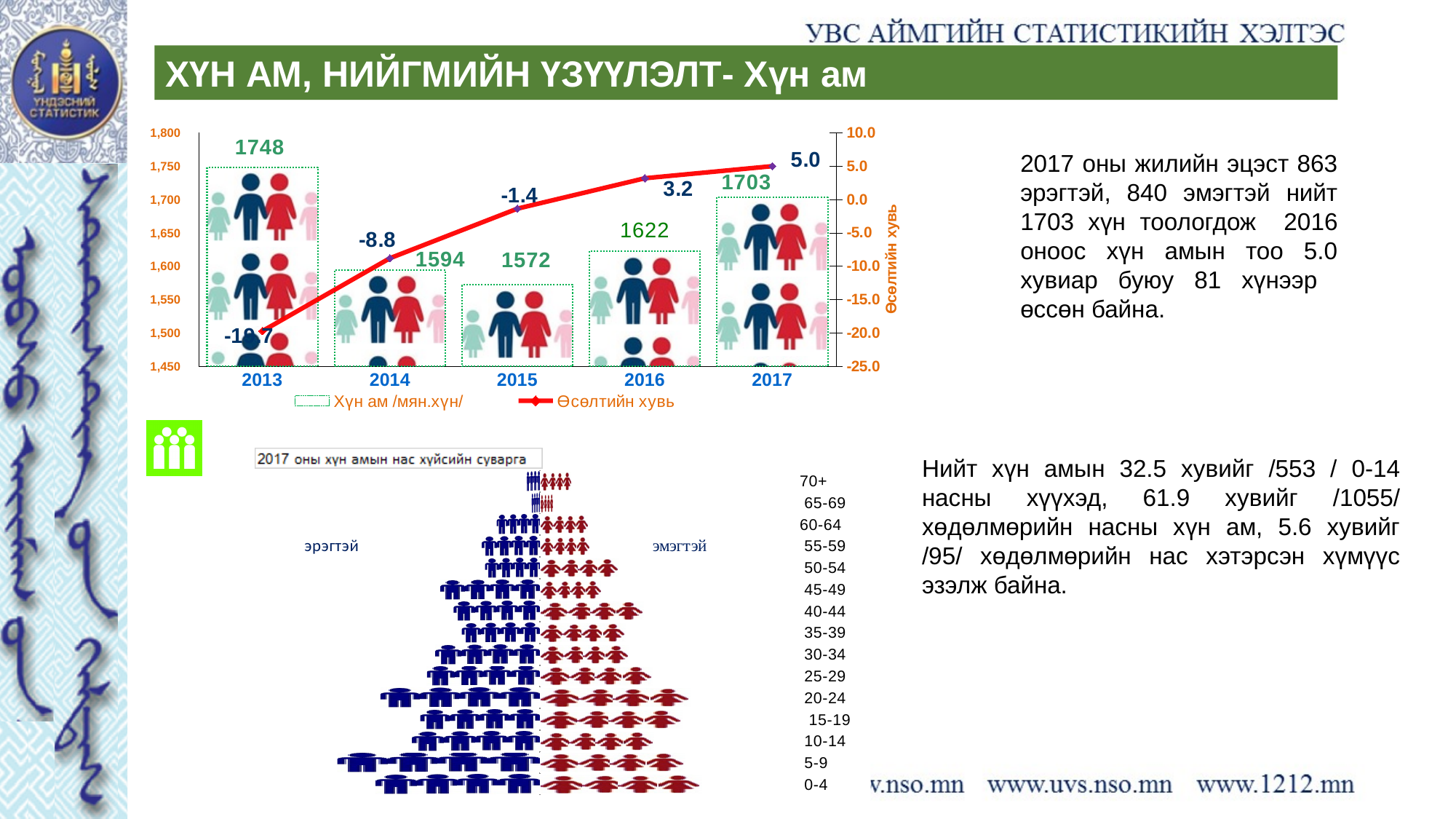
In the top chart, what is the population (Хүн ам) value shown for 2013? 1748 In the top chart, what is the difference between the population values for 2017 and 2016? 81 How many series does the legend of the top chart list? 2 How many years are shown on the x axis of the top chart? 5 In the top chart, which year has the highest population value? 2013 In the top chart, is the population value for 2016 larger or smaller than the value for 2015? larger In the top chart, what is the population value shown for 2017? 1703 In the top chart, what is the growth rate shown for 2017? 5.0 In the top chart, does the growth rate line rise or fall from 2013 to 2017? rise In the top chart, what is the growth rate (Өсөлтийн хувь) shown for 2014? -8.8 In the top chart, which year has the lowest population value? 2015 How many age groups are listed in the bottom population pyramid chart? 15